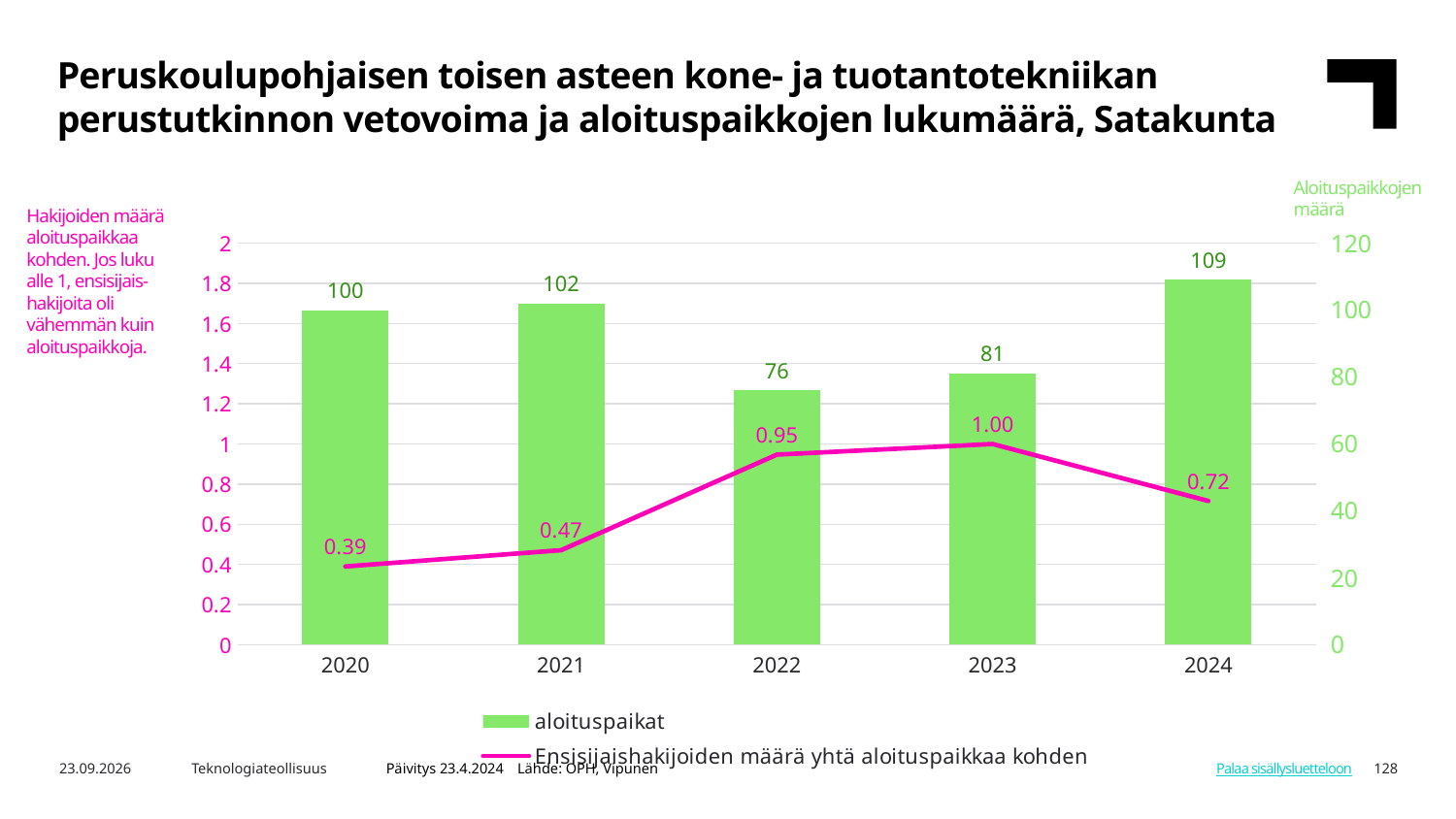
What colour are the aloituspaikat bars? green What kind of chart is used for the aloituspaikat series? bar chart What is the value of Ensisijaishakijoiden määrä yhtä aloituspaikkaa kohden for 2020? 0.39 How many series does the legend list? 2 What is the value of aloituspaikat for 2022? 76 Which year has the larger value of aloituspaikat, 2021 or 2023? 2021 Does the Ensisijaishakijoiden määrä yhtä aloituspaikkaa kohden line rise or fall from 2020 to 2023? rise What is the value of aloituspaikat for 2024? 109 Which year has the highest value of aloituspaikat? 2024 How many years are shown on the x axis? 5 Which year has the lowest value of Ensisijaishakijoiden määrä yhtä aloituspaikkaa kohden? 2020 What is the difference in aloituspaikat between 2024 and 2022? 33